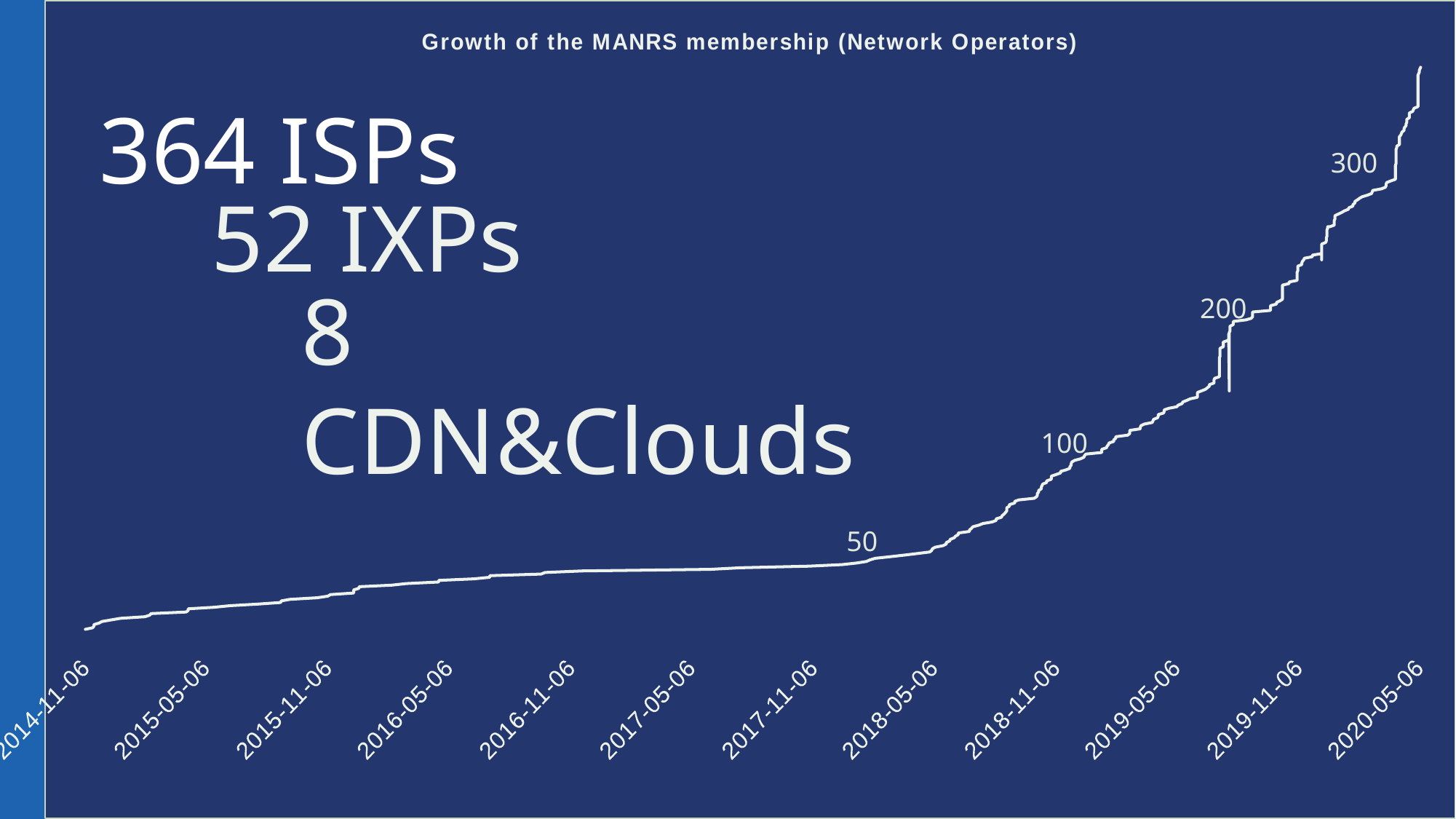
What is the lowest data label printed on the line in the chart? 50 Is the value of the line at 2017-05-06 greater or less than 50? less How many date labels are shown along the x axis of the chart? 12 What kind of chart is shown on the slide? line chart What is the highest data label printed on the line in the chart? 300 Does the line in the chart rise or fall from 2014-11-06 to 2020-05-06? rise Is the value of the line at 2019-11-06 greater or less than 200? greater Which is larger, the value of the line at 2016-05-06 or at 2019-05-06? 2019-05-06 What is the first date label on the x axis of the chart? 2014-11-06 Is the value of the line at 2020-05-06 greater or less than 300? greater What is the title of the chart? Growth of the MANRS membership (Network Operators)